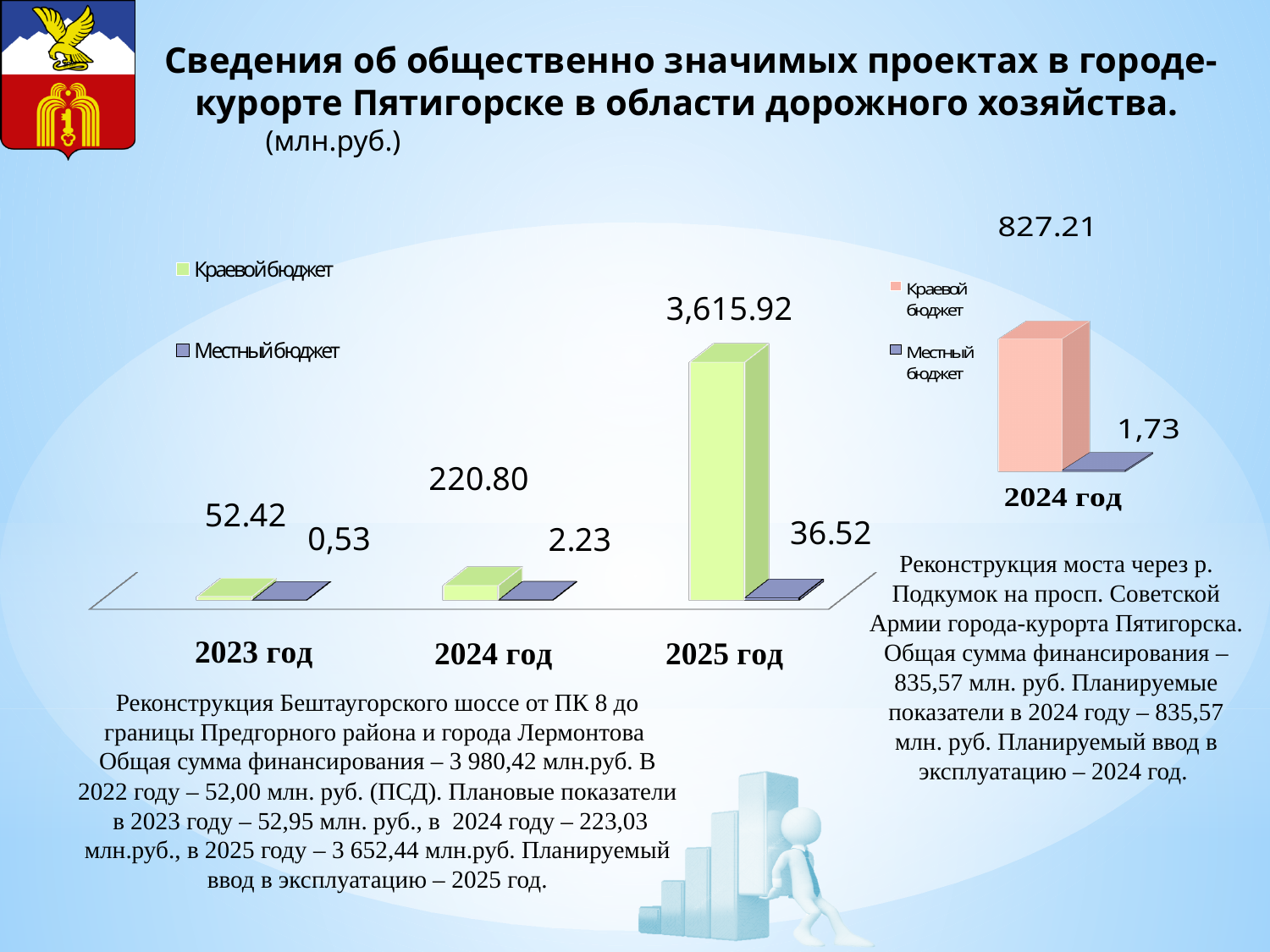
What kind of chart is the left chart? Bar chart In the left chart, which year has the highest value for Краевой бюджет? 2025 год In the left chart, what is the value for Местный бюджет in 2024 год? 2.23 In the left chart, what is the value for Краевой бюджет in 2025 год? 3,615.92 How many series does the legend of the right chart list? 2 In the left chart, which year has the lowest value for Местный бюджет? 2023 год How many years are shown on the x axis of the left chart? 3 In the left chart, what is the value for Краевой бюджет in 2023 год? 52.42 In the right chart, what is the value for Краевой бюджет in 2024 год? 827.21 In the left chart, what is the difference between Краевой бюджет and Местный бюджет in 2025 год? 3,579.40 In the left chart, which is larger in 2024 год: Краевой бюджет or Местный бюджет? Краевой бюджет In the right chart, what is the value for Местный бюджет in 2024 год? 1,73